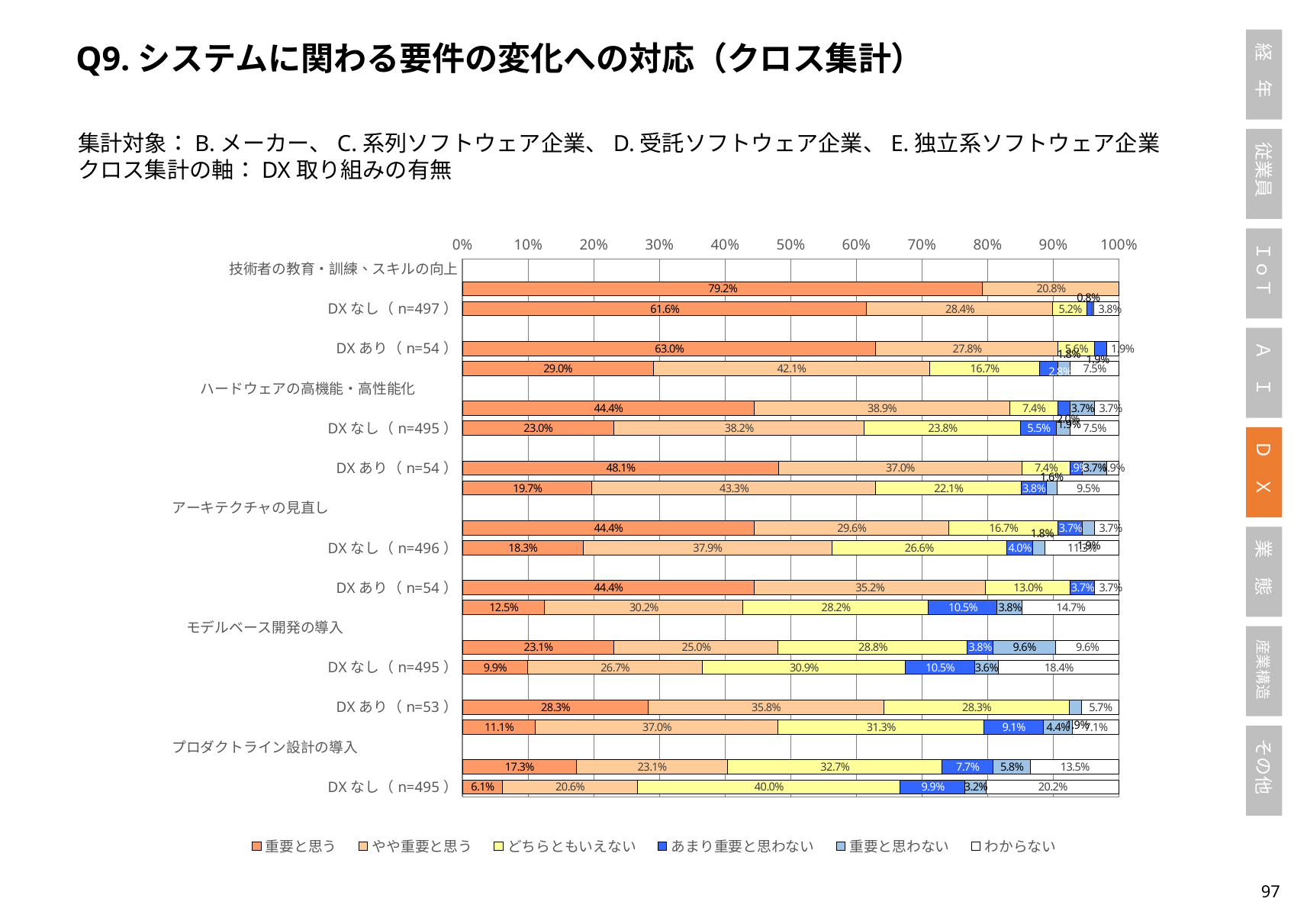
How many series does the legend list? 6 In the topmost bar of the chart, what is the value of the 重要と思う segment? 79.2% In the bottom bar of the chart, what is the value of the 重要と思う segment? 6.1% In the topmost bar of the chart, what is the value of the やや重要と思う segment? 20.8% What kind of chart is shown on the slide? Stacked bar chart What is the largest 重要と思う value printed anywhere on the chart? 79.2% What is the first entry in the chart legend? 重要と思う In the bottom bar of the chart, what is the value of the わからない segment? 20.2% In the topmost bar, which is larger: the 重要と思う segment or the やや重要と思う segment? 重要と思う In the topmost bar, what is the difference between the 重要と思う value and the やや重要と思う value? 58.4 percentage points What is the maximum value shown on the horizontal axis? 100% In the bottom bar of the chart, what is the value of the どちらともいえない segment? 40.0%